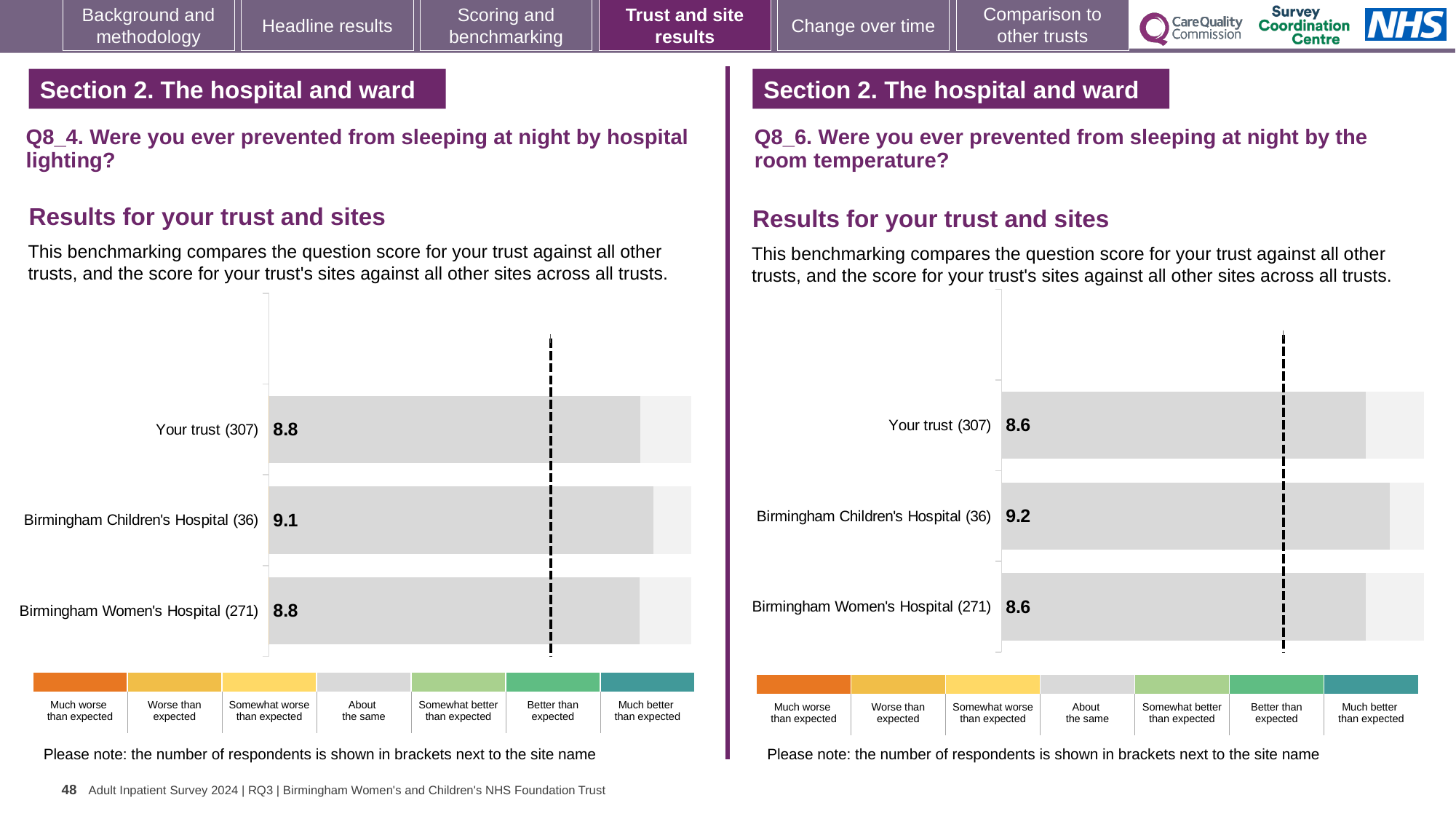
What kind of chart is used for the Q8_6 results (room temperature)? Bar chart In the Q8_6 chart (room temperature), what is the score for Birmingham Women's Hospital? 8.6 In the Q8_4 chart (hospital lighting), which site or trust has the highest score? Birmingham Children's Hospital In the Q8_6 chart (room temperature), what is the difference between the scores for Birmingham Children's Hospital and Your trust? 0.6 In the Q8_6 chart (room temperature), which has the larger score, Birmingham Children's Hospital or Birmingham Women's Hospital? Birmingham Children's Hospital In the Q8_4 chart (hospital lighting), what is the score for Your trust? 8.8 In the Q8_6 chart (room temperature), what is the score for Birmingham Children's Hospital? 9.2 In the Q8_6 chart (room temperature), which site or trust has the highest score? Birmingham Children's Hospital In the Q8_4 chart (hospital lighting), how many respondents are shown in brackets for Birmingham Women's Hospital? 271 In the Q8_4 chart (hospital lighting), what is the score for Birmingham Children's Hospital? 9.1 In the Q8_4 chart (hospital lighting), what is the difference between the scores for Birmingham Children's Hospital and Birmingham Women's Hospital? 0.3 How many bars are plotted in the Q8_4 chart (hospital lighting)? 3